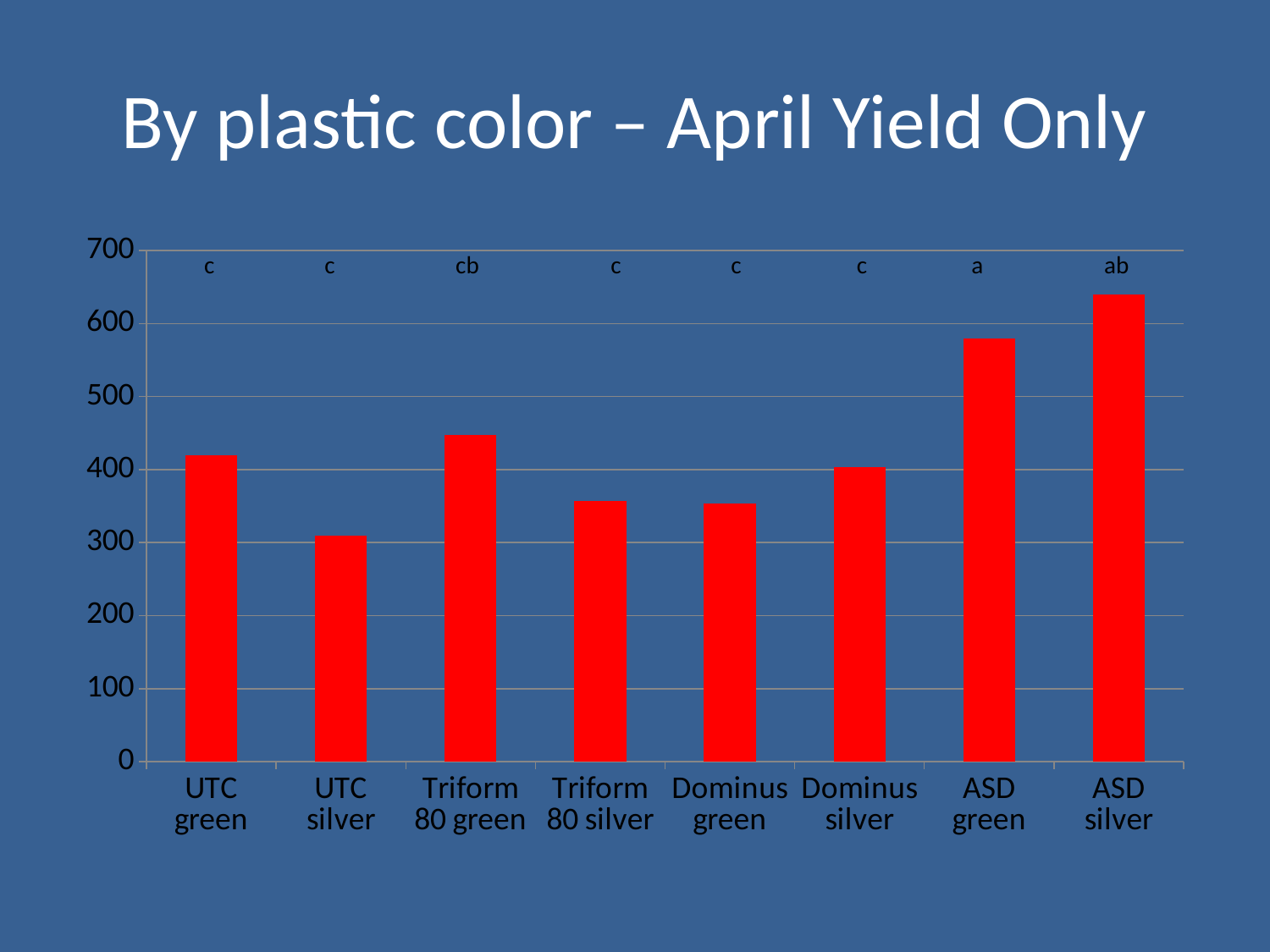
Which category has the lowest bar? UTC silver Is the value for ASD silver greater or less than 600? greater How many categories are plotted on the chart? 8 Which is larger, the value for Triform 80 green or the value for Triform 80 silver? Triform 80 green What kind of chart is shown on the slide? bar chart Which is larger, the value for ASD green or the value for UTC green? ASD green Is the value for Triform 80 silver greater or less than 400? less Which category has the highest bar? ASD silver What is the title of the slide? By plastic color – April Yield Only Is the value for UTC green greater or less than 400? greater